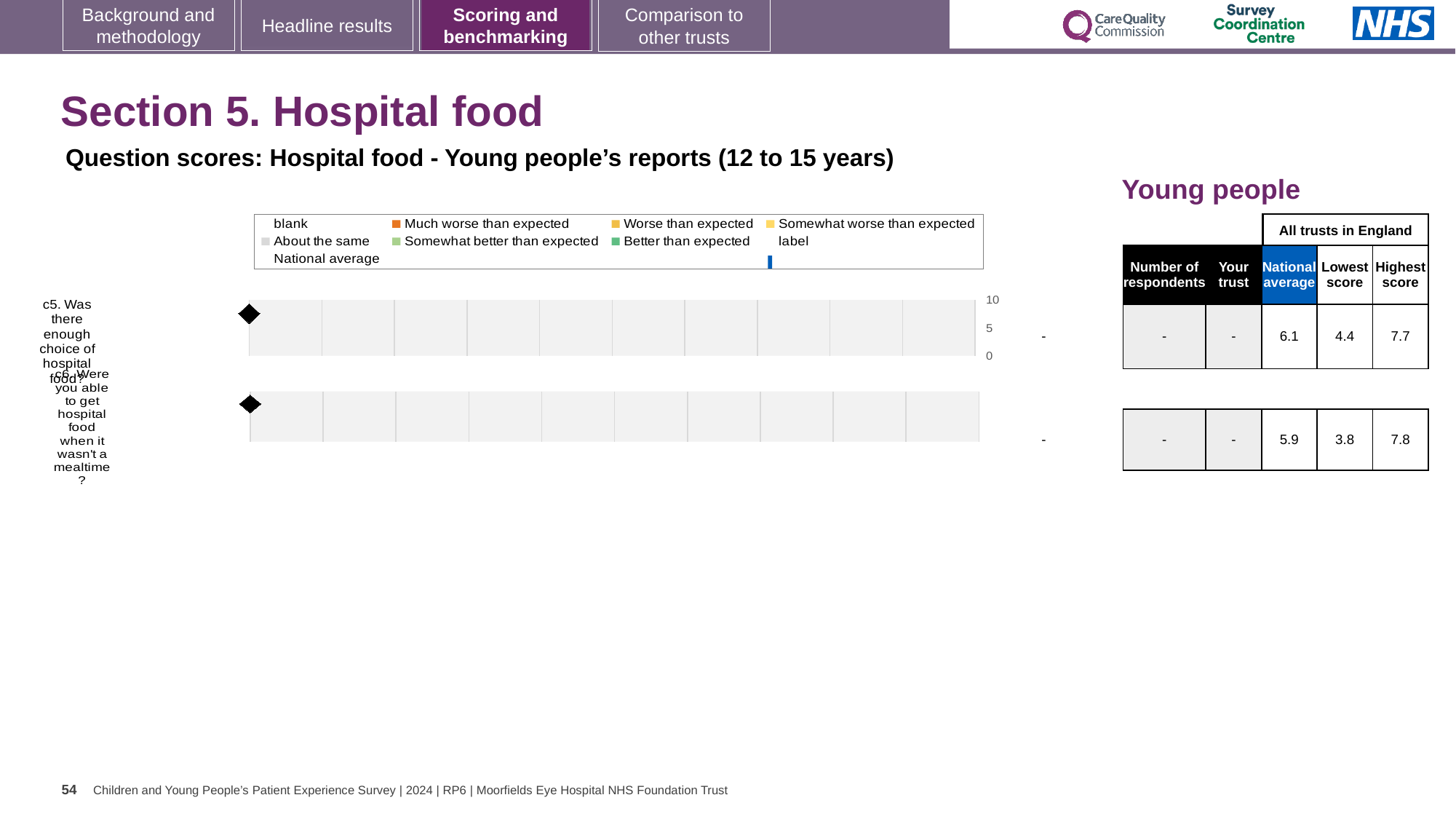
In the table beside the chart, what is shown as the 'Your trust' score for c5? - What kind of chart is shown on the slide? bar chart In the table beside the chart, what is the difference between the national averages for c5 and c6? 0.2 In the table beside the chart, what is the difference between the highest score and the lowest score for c5? 3.3 In the table beside the chart, is the national average for c6 greater or less than 5? greater In the table beside the chart, what is the national average score for c5 (enough choice of hospital food)? 6.1 How many survey questions (categories) are listed on the chart's vertical axis? 2 In the table beside the chart, what is the lowest score for c6 (able to get hospital food when it wasn't a mealtime)? 3.8 What is the maximum value shown on the chart's horizontal axis? 10 In the table beside the chart, what is the highest score for c5? 7.7 What colour is the legend marker for 'Better than expected'? green In the table beside the chart, which question has the higher national average, c5 or c6? c5